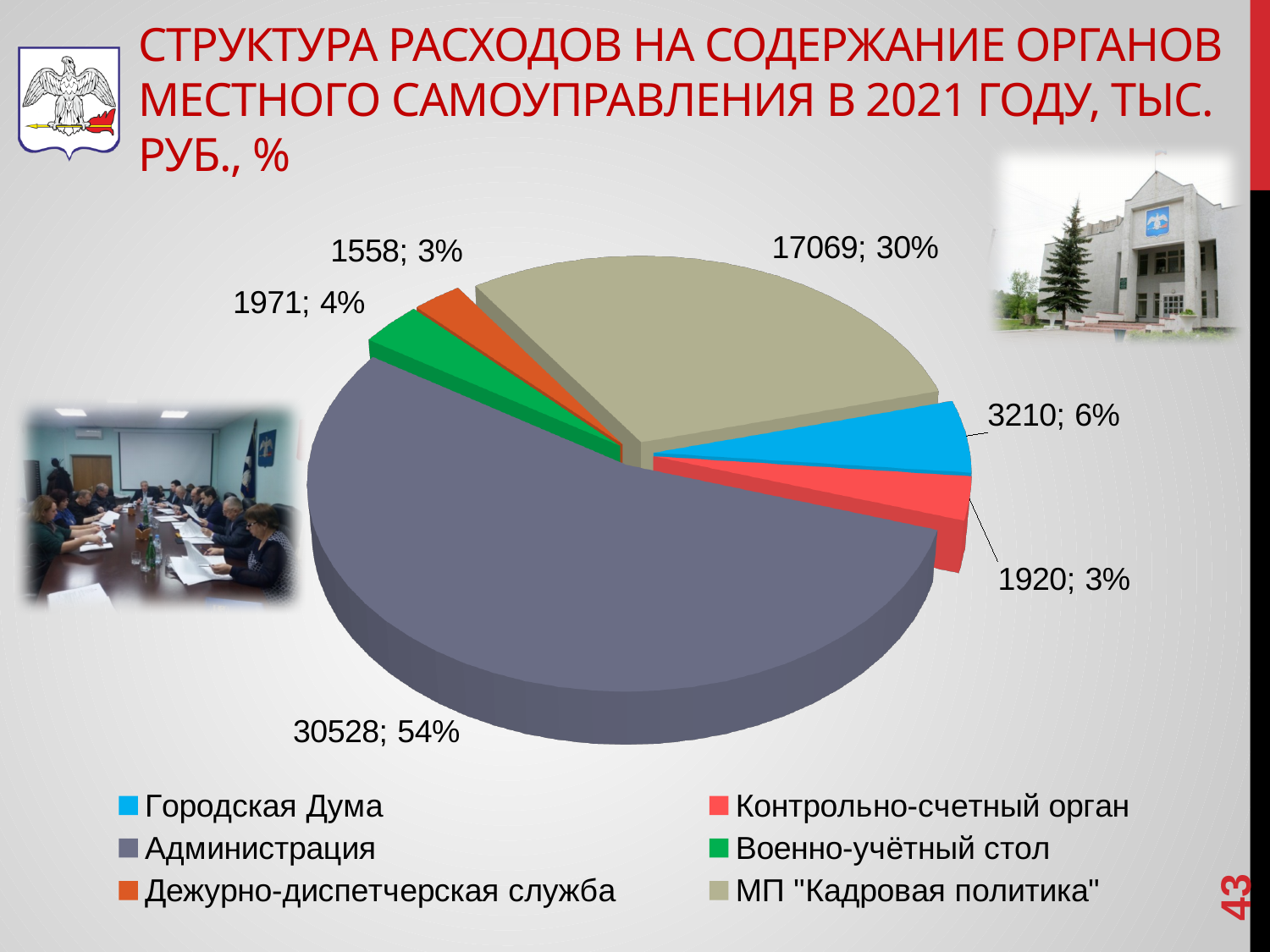
What is the value for Администрация? 30528 How many slices does the pie chart have? 6 What is the value for МП "Кадровая политика"? 17069 Which is larger, the value for Городская Дума or the value for Военно-учётный стол? Городская Дума Which category has the smallest slice? Дежурно-диспетчерская служба Which category has the largest slice? Администрация What is the difference between the values for Администрация and МП "Кадровая политика"? 13459 What share of the pie does Администрация take? 54% What is the value for Контрольно-счетный орган? 1920 What share of the pie does Городская Дума take? 6% What kind of chart is shown on the slide? Pie chart What is the value for Дежурно-диспетчерская служба? 1558